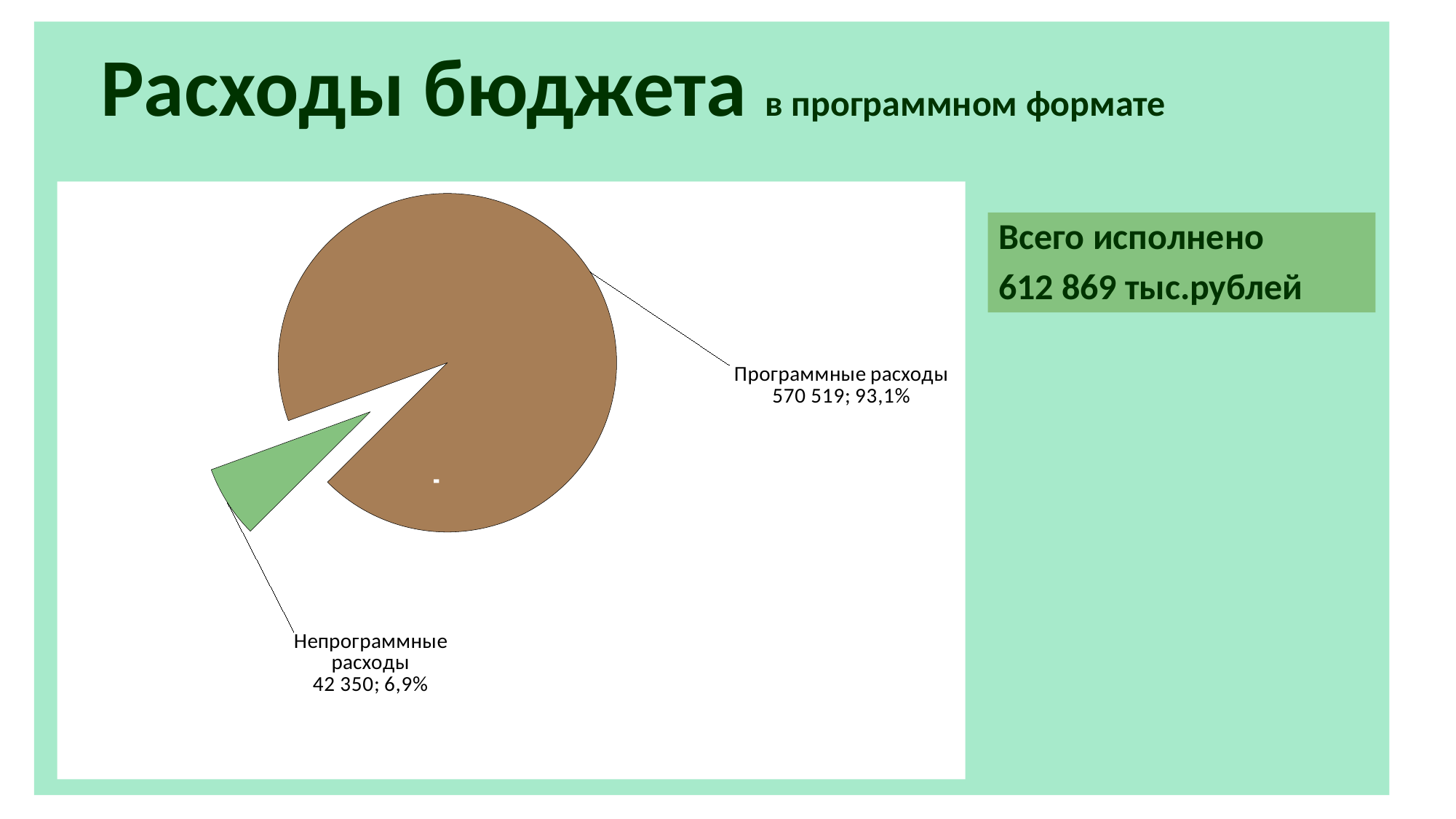
What is the value for Непрограммные расходы? 42 350 What is the difference between the values for Программные расходы and Непрограммные расходы? 528 169 What is the value for Программные расходы? 570 519 What colour is the Непрограммные расходы slice? green Which slice is the largest? Программные расходы Which slice is the smallest? Непрограммные расходы Which is larger, Программные расходы or Непрограммные расходы? Программные расходы What kind of chart is shown on the slide? pie chart What share of the pie is Непрограммные расходы? 6,9% How many slices does the pie chart have? 2 What share of the pie is Программные расходы? 93,1% What is the total of the two slices in the pie chart? 612 869